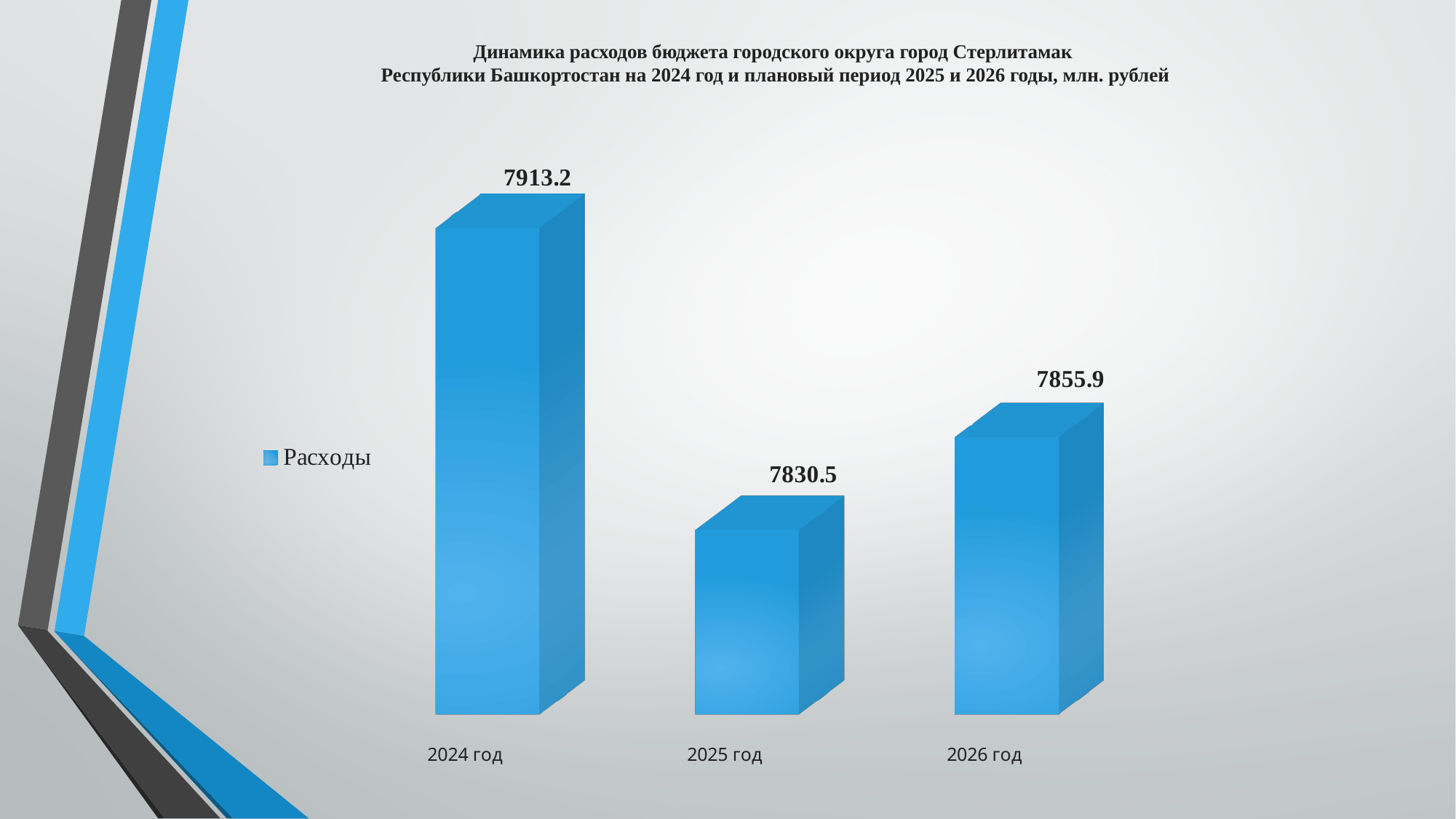
What is the value for 2026 год? 7855.9 What is the value for 2025 год? 7830.5 Which year has the lowest value? 2025 год How many series does the legend list? 1 How many categories are shown on the chart? 3 Which is larger, the value for 2026 год or the value for 2025 год? 2026 год What kind of chart is shown? bar chart What is the value for 2024 год? 7913.2 Which year has the highest value? 2024 год What is the difference between the values for 2026 год and 2025 год? 25.4 What is the name of the series in the legend? Расходы What is the difference between the values for 2024 год and 2025 год? 82.7